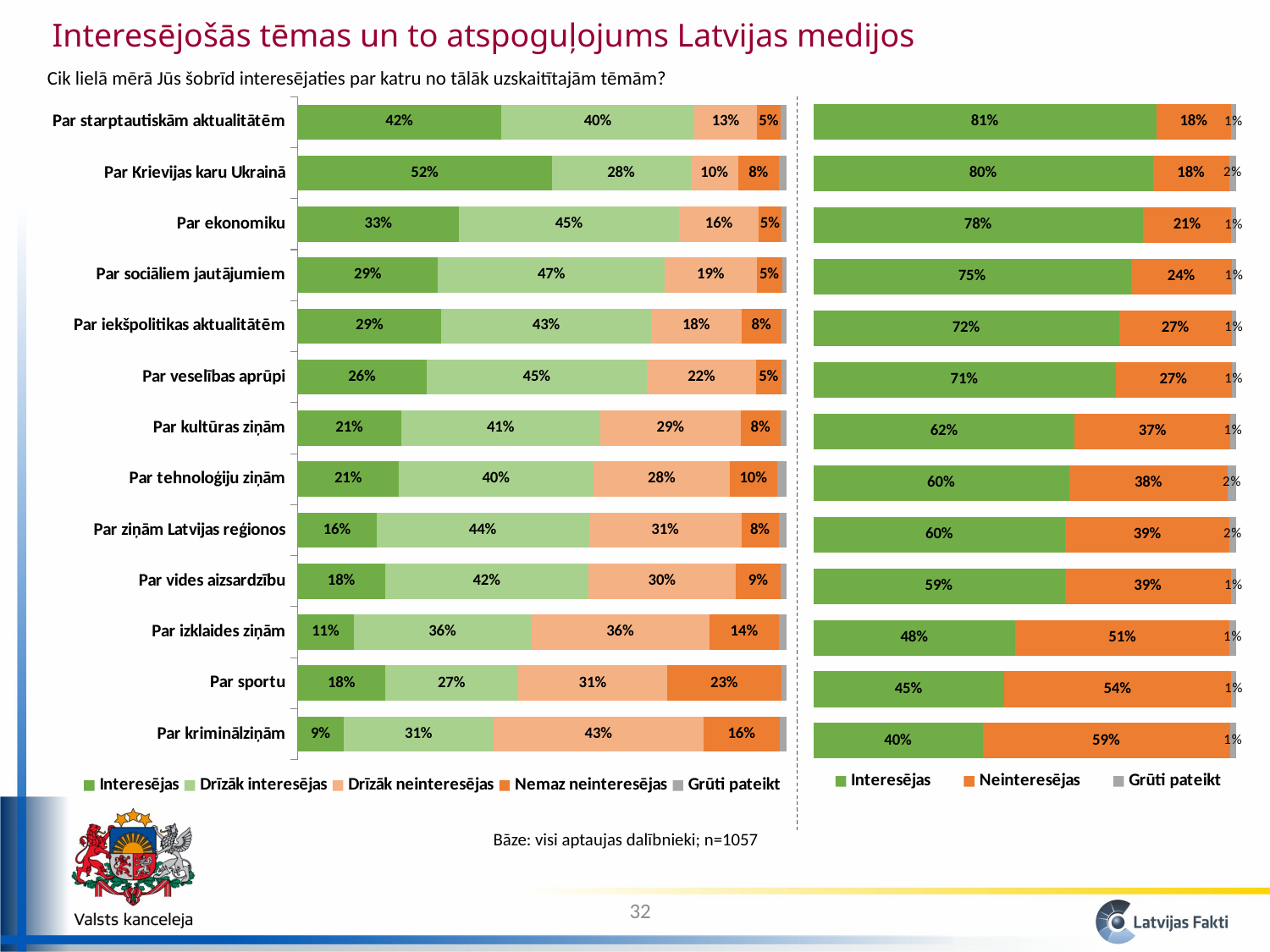
In the left chart, what is the 'Interesējas' value for 'Par Krievijas karu Ukrainā'? 52% In the right chart, what is the 'Neinteresējas' value for 'Par sportu'? 54% In the left chart, what is the 'Drīzāk neinteresējas' value for 'Par kriminālziņām'? 43% How many series does the legend of the left chart list? 5 What kind of chart is the right chart? Stacked bar chart How many topics (categories) are shown in the left chart? 13 In the right chart, what is the total of the stacked bar for 'Par ekonomiku'? 100% In the right chart, which topic has the highest 'Interesējas' value? Par starptautiskām aktualitātēm In the left chart, which has the larger 'Nemaz neinteresējas' value: 'Par sportu' or 'Par izklaides ziņām'? Par sportu In the right chart, what is the difference in 'Interesējas' between 'Par starptautiskām aktualitātēm' and 'Par kriminālziņām'? 41 percentage points What are the three legend entries of the right chart? Interesējas, Neinteresējas, Grūti pateikt In the left chart, which topic has the lowest 'Interesējas' value? Par kriminālziņām